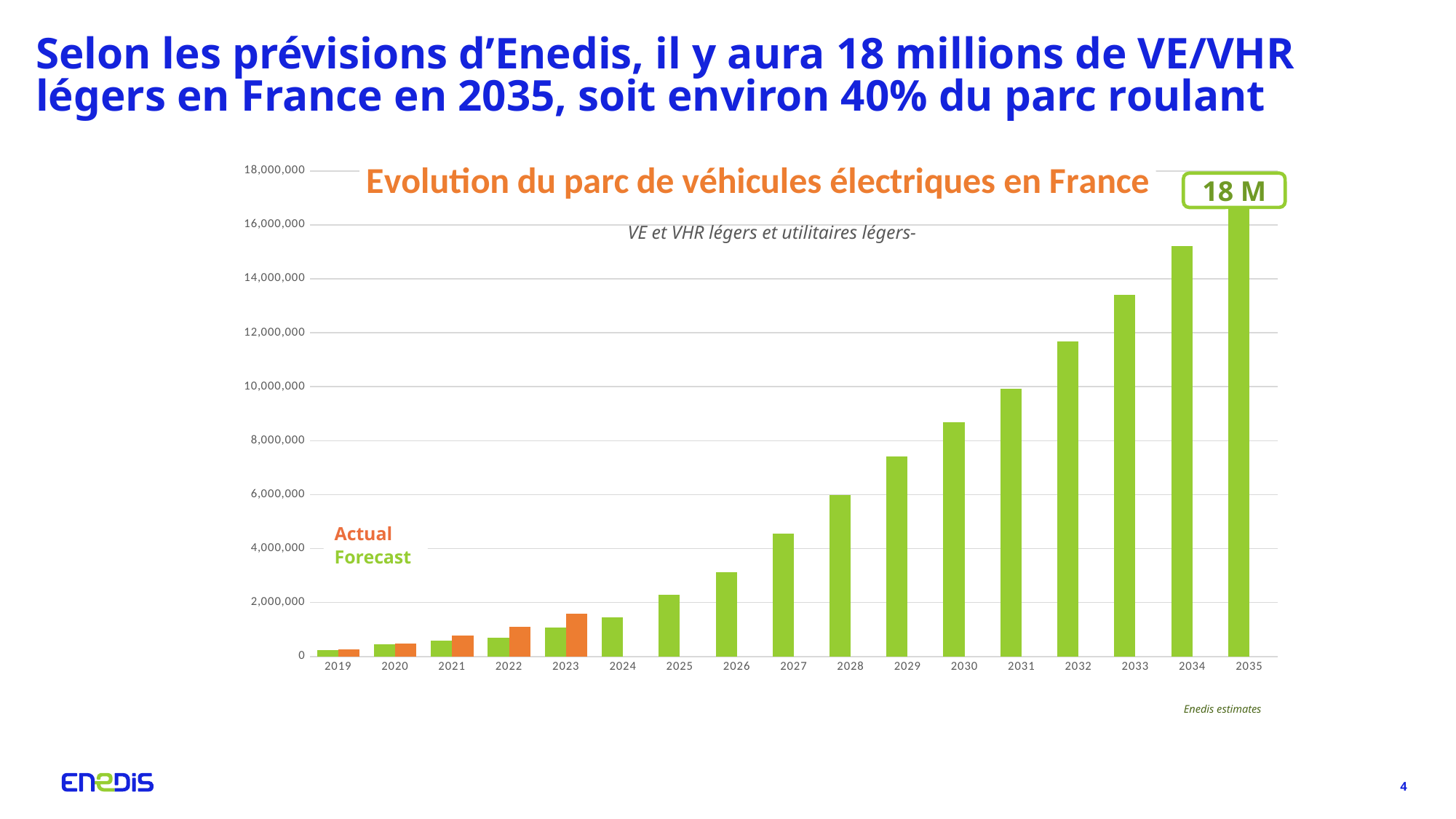
How many years are shown along the x axis of the chart? 17 Is the forecast value for 2034 greater or less than 14,000,000? greater For 2023, which is larger: the Actual bar or the Forecast bar? Actual How many series does the chart's legend list? 2 What kind of chart is shown on the slide? Bar chart What is the title of the chart? Evolution du parc de véhicules électriques en France Is the forecast value for 2029 greater or less than 8,000,000? less Is the forecast value for 2030 greater or less than 8,000,000? greater Which year has the lowest forecast bar? 2019 What value is labelled on the forecast bar for 2035? 18 M Do the forecast values rise or fall from 2024 to 2035? rise Which year has the highest forecast bar? 2035